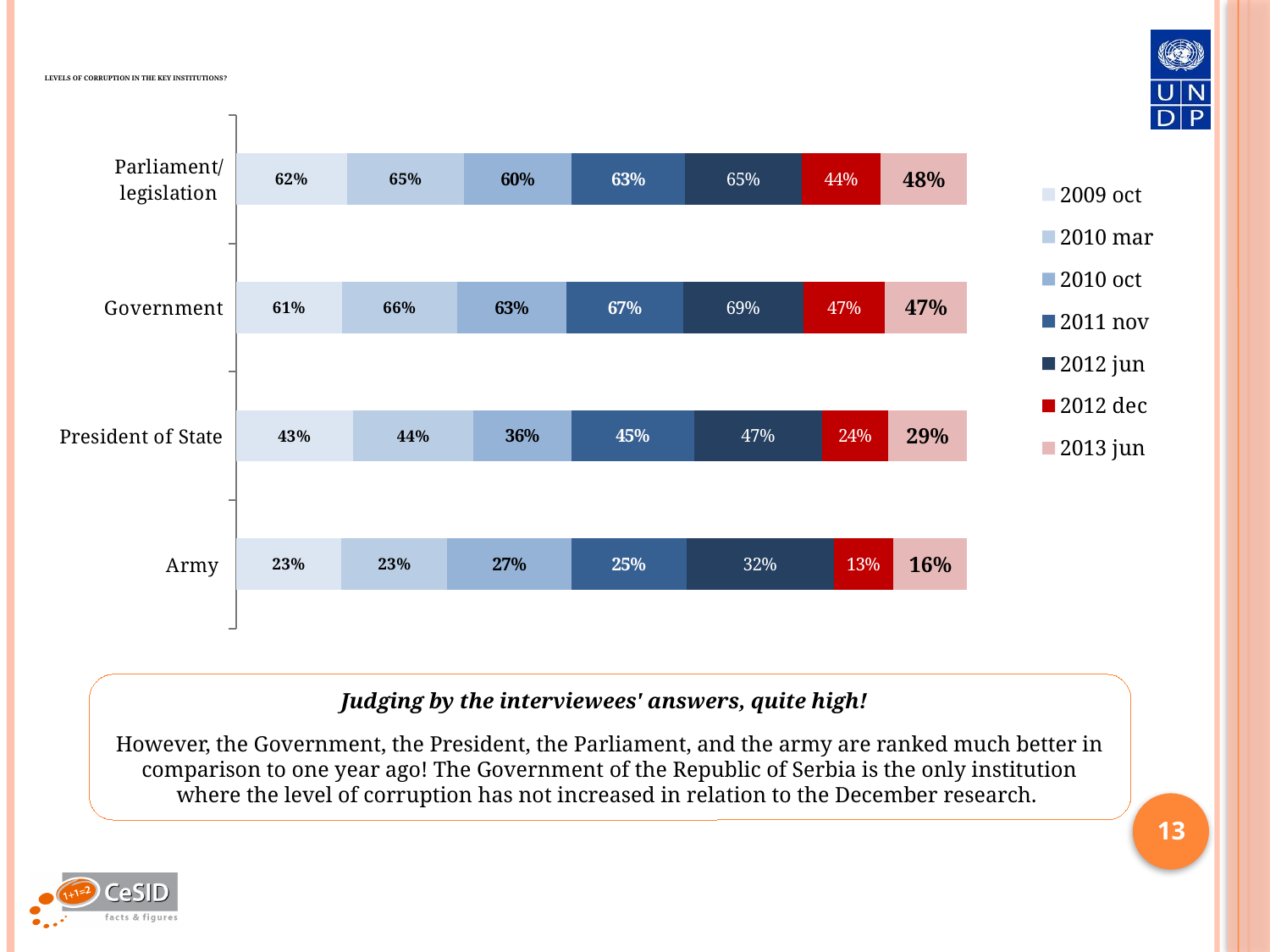
Which is larger for President of State: the 2011 nov value or the 2013 jun value? 2011 nov What is the difference between the 2012 jun and 2012 dec values for Government? 22% What is the value for Army in 2012 jun? 32% Which legend entry is shown in red? 2012 dec How many series does the legend list? 7 What kind of chart is shown on the slide? Stacked bar chart Which institution has the highest value in 2013 jun? Parliament/legislation Which institution has the lowest value in 2012 dec? Army What is the value for President of State in 2010 oct? 36% What is the value for Government in 2013 jun? 47% What is the value for Parliament/legislation in 2012 dec? 44% How many institutions are shown on the chart? 4